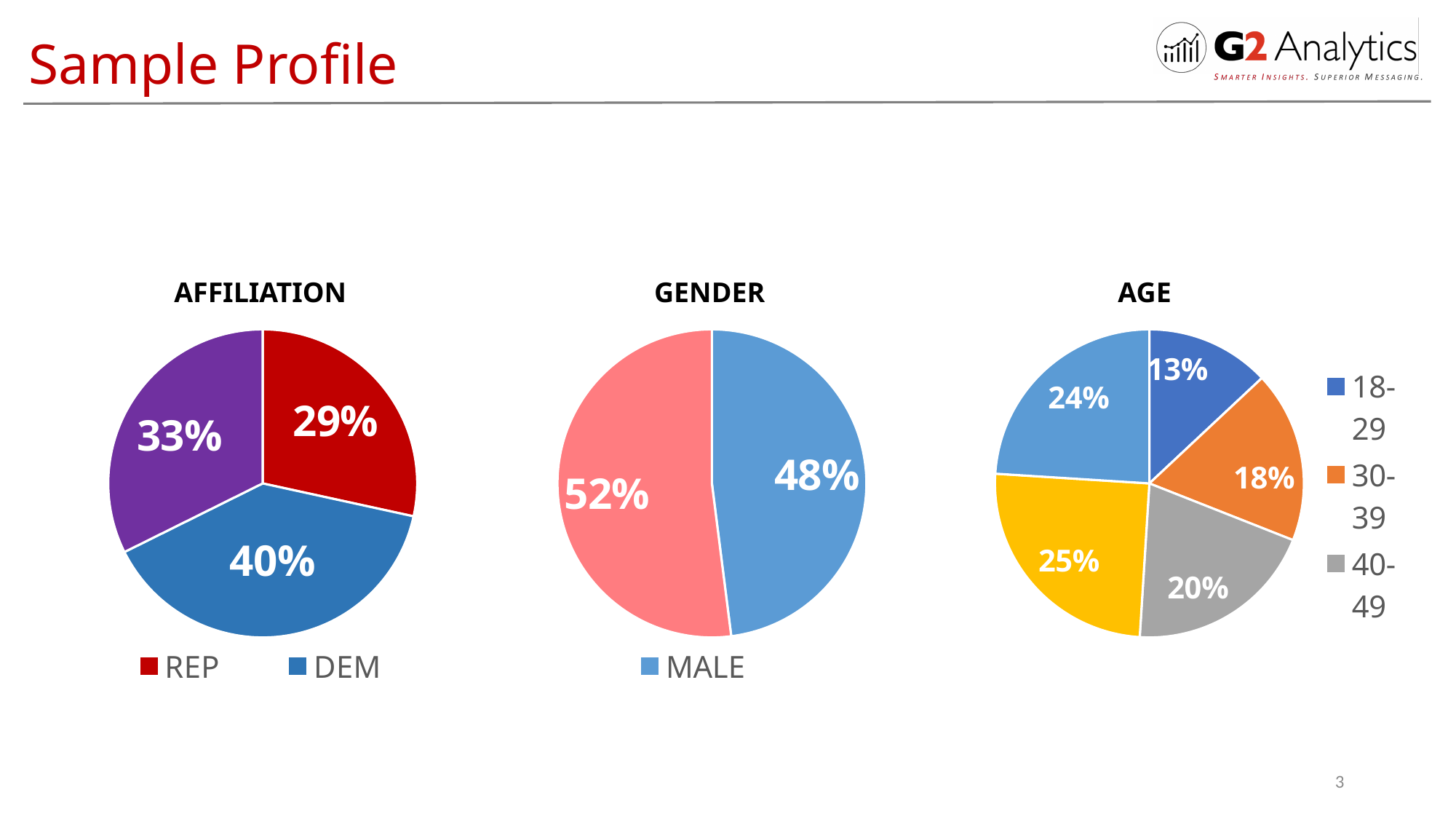
In the GENDER chart, what share of the sample is MALE? 48% In the AFFILIATION chart, what share of the sample is DEM? 40% In the AGE chart, what share of the sample is aged 18-29? 13% In the AFFILIATION chart, how many slices does the pie have? 3 In the GENDER chart, what is the value of the larger slice? 52% In the AGE chart, what share of the sample is aged 40-49? 20% What kind of chart is used for the AGE breakdown? Pie chart In the AGE chart, how many slices does the pie have? 5 In the AFFILIATION chart, which of REP or DEM has the larger share? DEM In the AFFILIATION chart, what is the difference in percentage points between DEM and REP? 11 In the AGE chart, what share of the sample is aged 30-39? 18% In the AFFILIATION chart, what share of the sample is REP? 29%